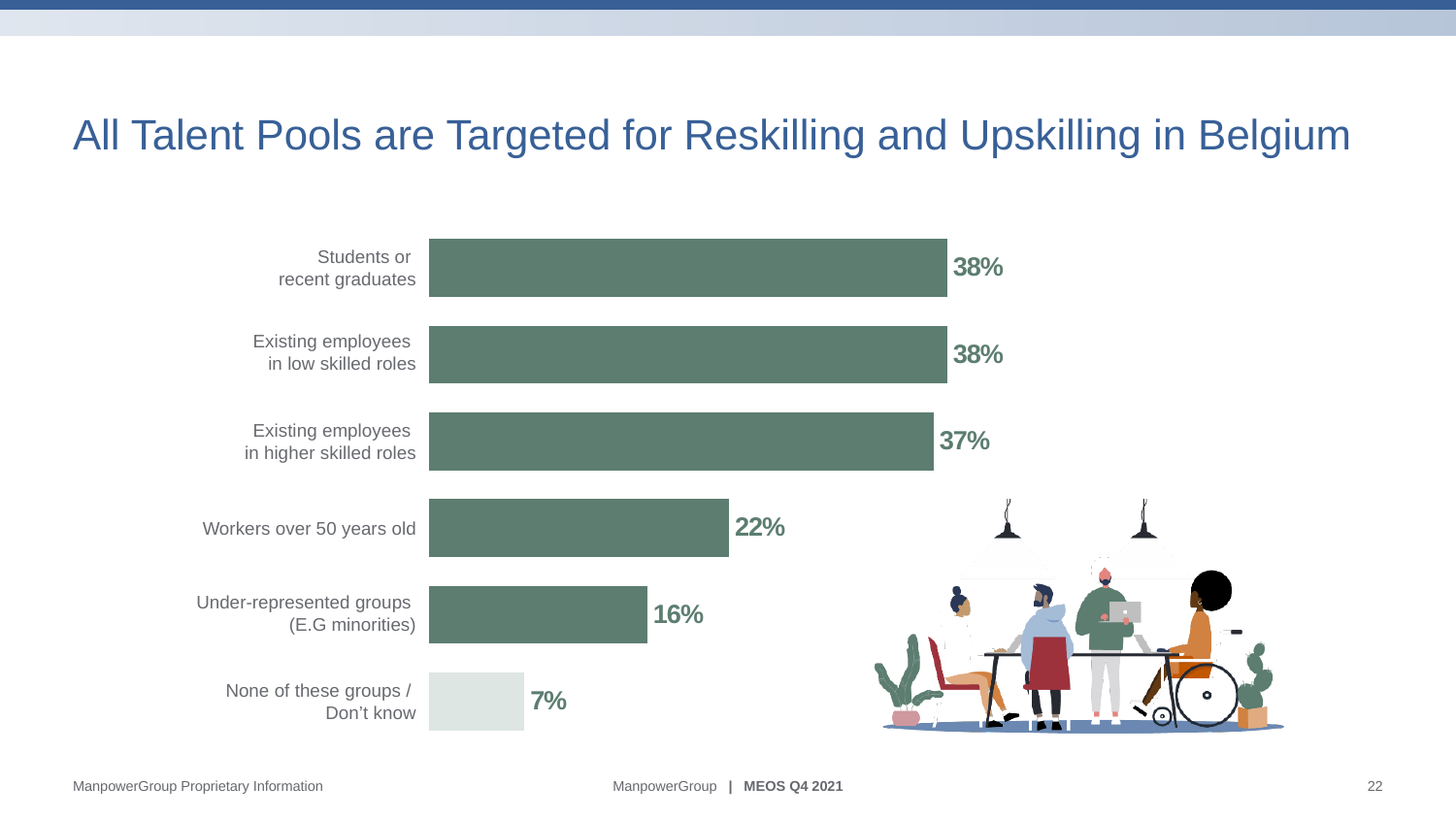
What percentage is shown for Workers over 50 years old? 22% Which is larger: the value for Workers over 50 years old or the value for Under-represented groups (E.G minorities)? Workers over 50 years old What is the difference between the value for Under-represented groups (E.G minorities) and the value for None of these groups / Don't know? 9 percentage points What kind of chart is shown on the slide? Bar chart What is the title of the slide containing the chart? All Talent Pools are Targeted for Reskilling and Upskilling in Belgium What is the value for Under-represented groups (E.G minorities)? 16% What is the value for Students or recent graduates? 38% What is the highest value shown on the chart? 38% How many categories are shown on the chart? 6 What percentage is shown for Existing employees in higher skilled roles? 37% Which category has the lowest value? None of these groups / Don't know What is the difference between the value for Existing employees in low skilled roles and the value for Workers over 50 years old? 16 percentage points